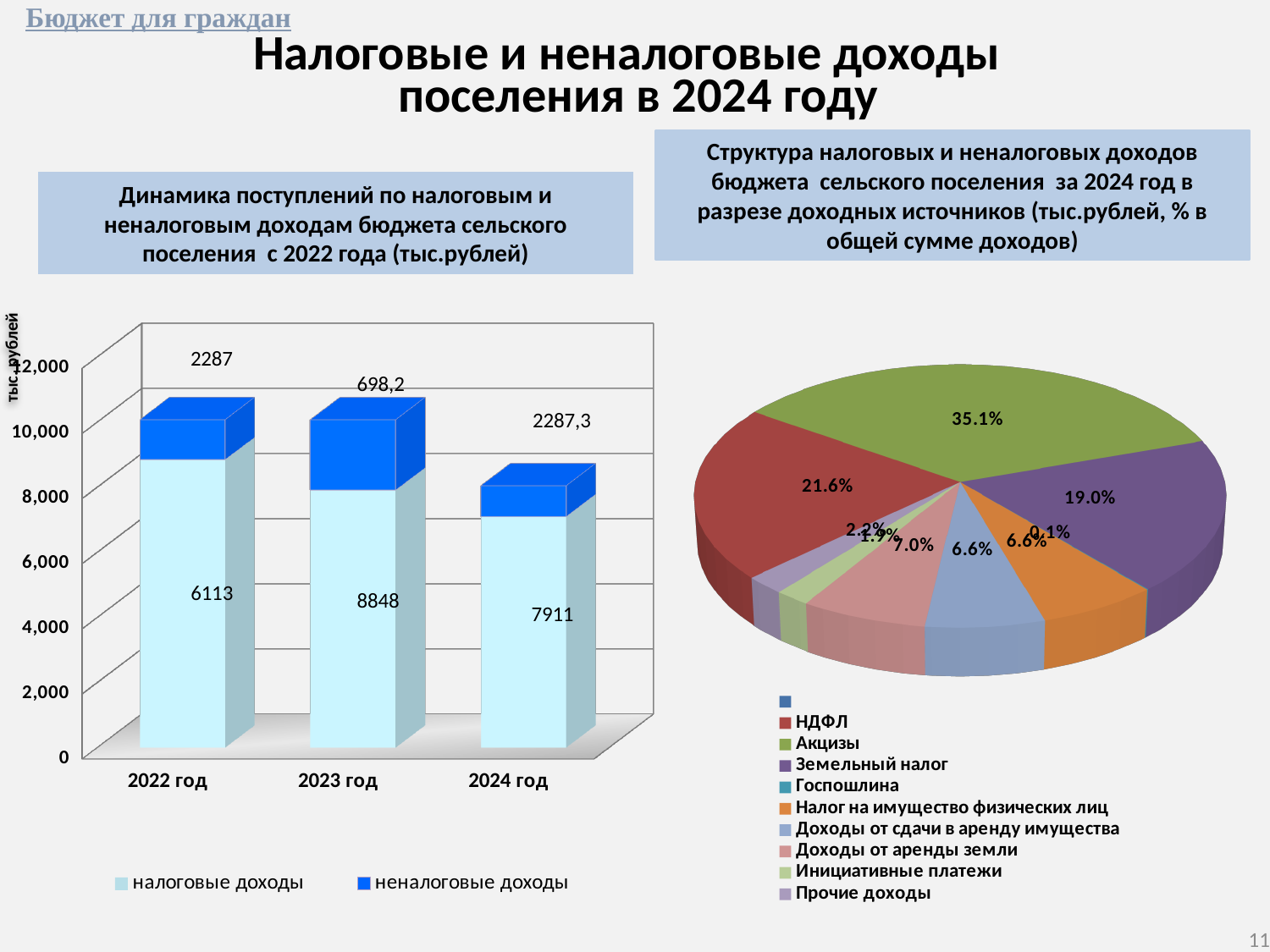
How many years (categories) are shown on the x axis of the left chart? 3 In the left chart, what is the value of налоговые доходы for 2023 год? 8848 What type of chart is the left chart (Динамика поступлений по налоговым и неналоговым доходам)? bar chart In the left chart, what is the difference between налоговые доходы in 2023 год and 2022 год? 2735 In the left chart, what is the value of неналоговые доходы for 2024 год? 2287,3 In the right pie chart, which source has the largest share? Акцизы In the right pie chart (Структура налоговых и неналоговых доходов), what share does Акцизы have? 35.1% How many series does the legend of the left chart list? 2 In the left chart, what is the value of неналоговые доходы for 2022 год? 2287 In the left chart, what is the value of налоговые доходы for 2024 год? 7911